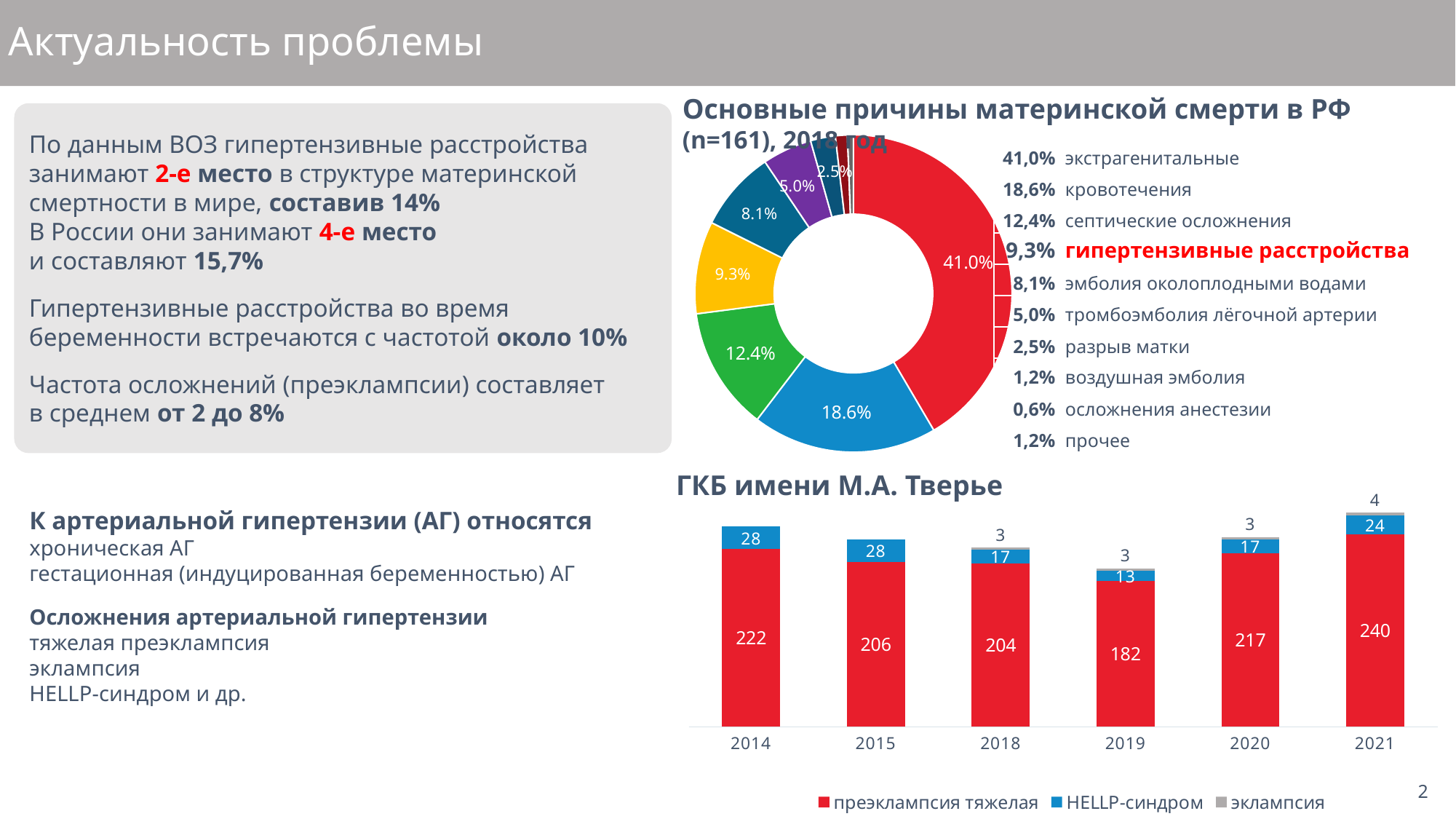
What type of chart is 'Основные причины материнской смерти в РФ (n=161), 2018 год'? Pie (doughnut) chart In the chart 'ГКБ имени М.А. Тверье', is the value for преэклампсия тяжелая larger in 2014 or in 2015? 2014 In the chart 'ГКБ имени М.А. Тверье', what is the value for HELLP-синдром in 2021? 24 In the chart 'Основные причины материнской смерти в РФ (n=161), 2018 год', which cause has the largest share? экстрагенитальные In the chart 'Основные причины материнской смерти в РФ (n=161), 2018 год', which cause has the smallest share? осложнения анестезии In the chart 'Основные причины материнской смерти в РФ (n=161), 2018 год', how many causes are listed? 10 In the chart 'ГКБ имени М.А. Тверье', what is the total of the stacked bar for 2021? 268 In the chart 'ГКБ имени М.А. Тверье', what is the value for преэклампсия тяжелая in 2019? 182 How many series does the legend of the chart 'ГКБ имени М.А. Тверье' list? 3 In the chart 'ГКБ имени М.А. Тверье', what is the difference between преэклампсия тяжелая in 2021 and in 2019? 58 In the chart 'Основные причины материнской смерти в РФ (n=161), 2018 год', what share is attributed to кровотечения? 18,6% In the chart 'ГКБ имени М.А. Тверье', which year has the highest value for преэклампсия тяжелая? 2021